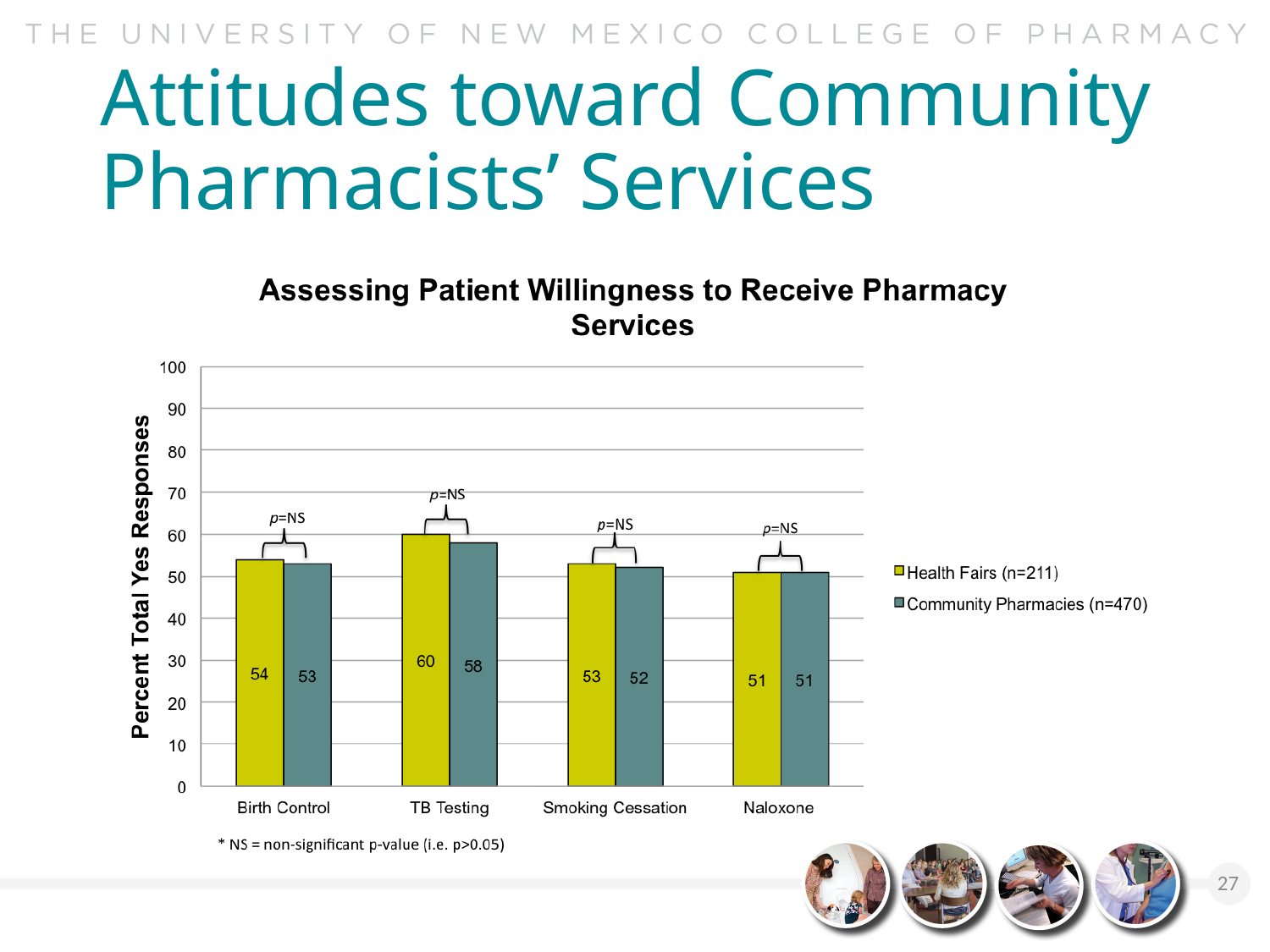
How many categories are shown on the x axis? 4 What is the difference between the Health Fairs and Community Pharmacies values for TB Testing? 2 What is the title of the chart? Assessing Patient Willingness to Receive Pharmacy Services Which category has the lowest Community Pharmacies value? Naloxone How many series does the legend list? 2 What is the Health Fairs value for Naloxone? 51 What is the difference between the Health Fairs values for TB Testing and Naloxone? 9 What kind of chart is shown? Bar chart What is the Community Pharmacies value for Smoking Cessation? 52 Which category has the highest Health Fairs value? TB Testing Which is larger: the Health Fairs value for Birth Control or the Health Fairs value for Smoking Cessation? Birth Control What is the Health Fairs value for TB Testing? 60